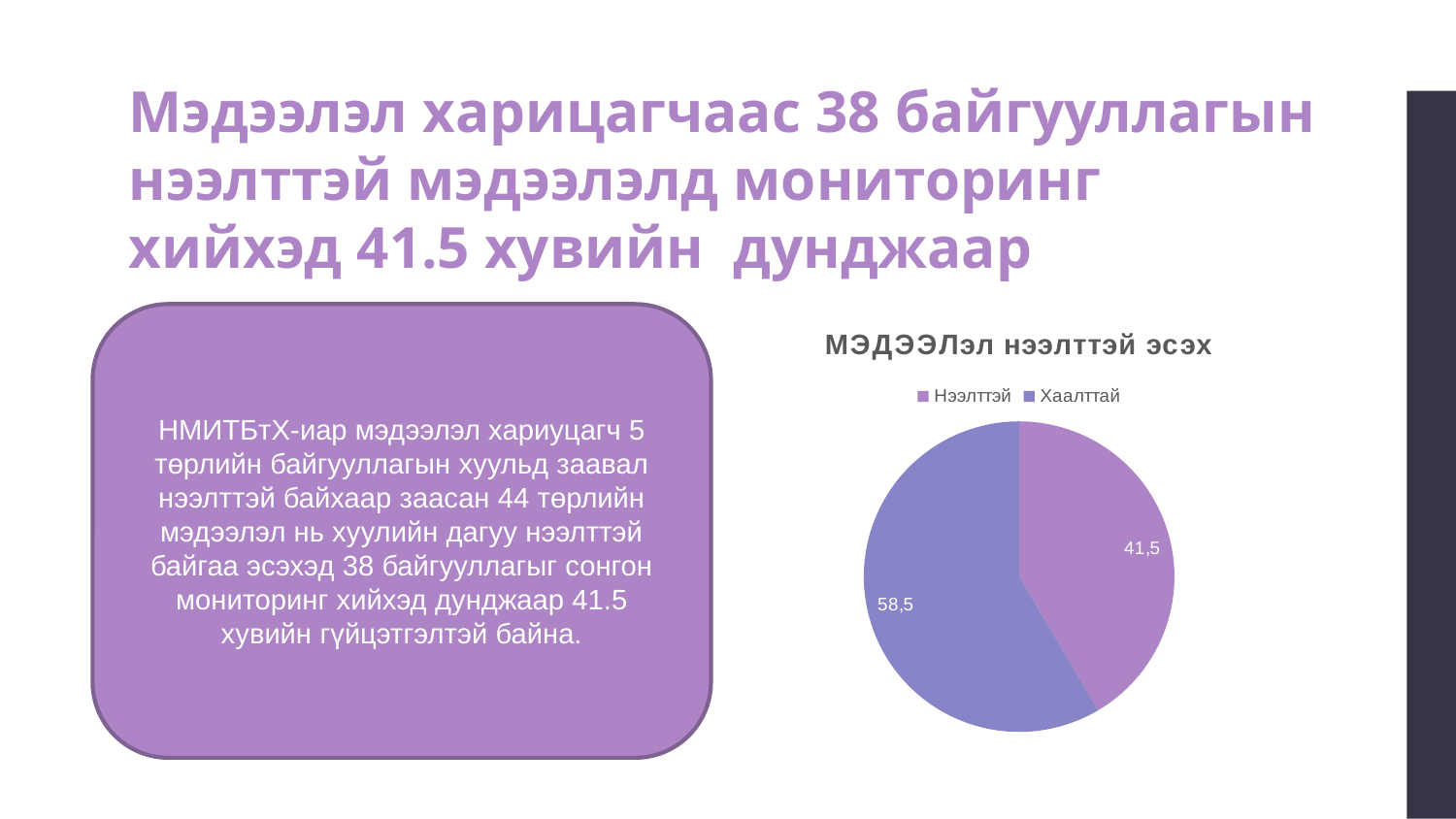
What is the value for Хаалттай in the pie chart? 58,5 What is the value for Нээлттэй in the pie chart? 41,5 What share of the pie does Хаалттай represent? 58,5% Which slice of the pie chart is the largest? Хаалттай Which legend entry is shown in the lighter purple colour? Нээлттэй What type of chart is shown on the slide? pie chart Which slice of the pie chart is the smallest? Нээлттэй What is the title of the chart? МЭДЭЭЛэл нээлттэй эсэх How many entries does the chart legend list? 2 Which is larger, Нээлттэй or Хаалттай? Хаалттай How many slices does the pie chart have? 2 What is the difference between the Хаалттай and Нээлттэй values? 17